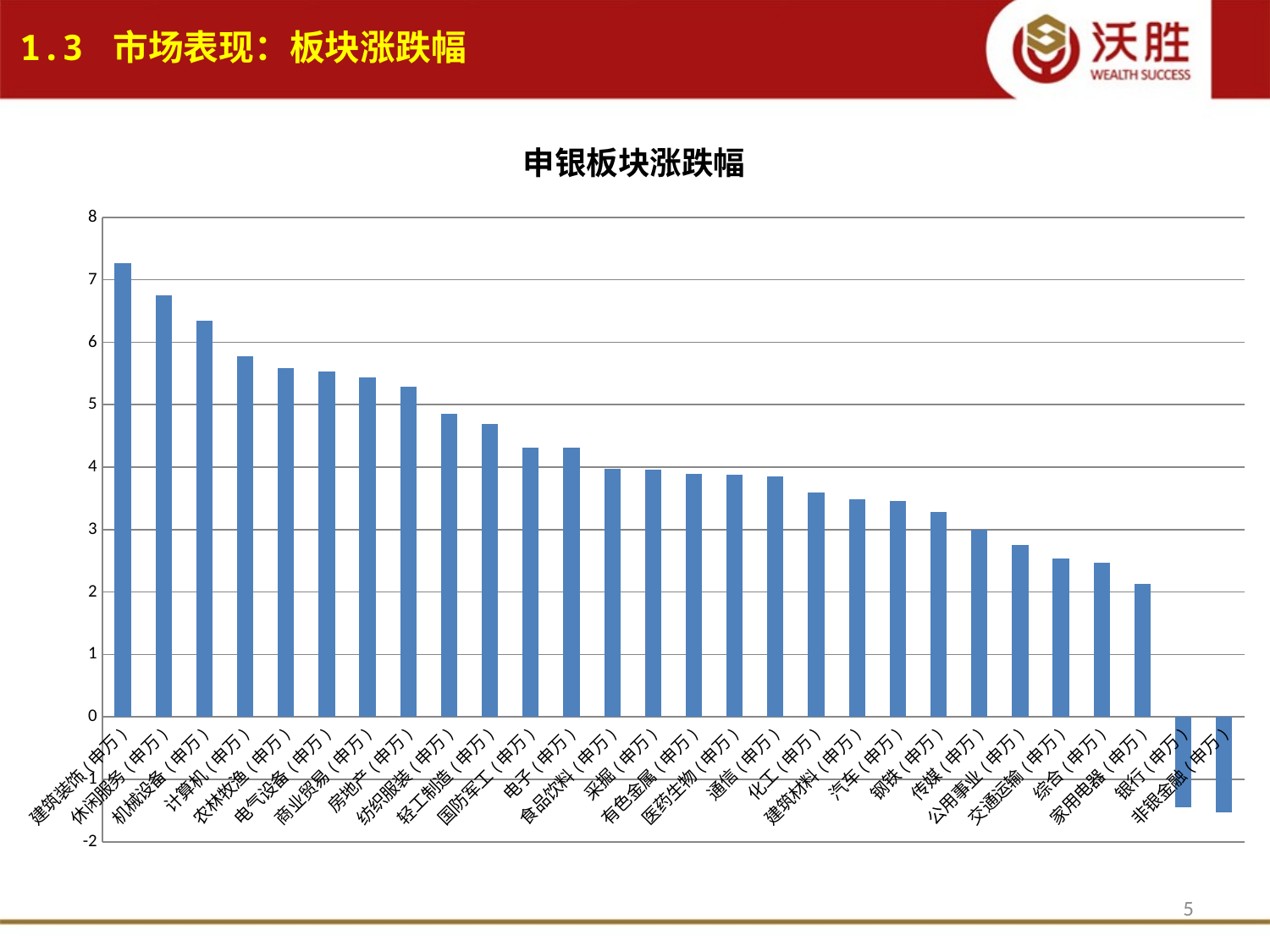
What is the title of the chart? 申银板块涨跌幅 Which sector has the highest value in the chart? 建筑装饰(申万) What kind of chart is shown on the slide? Bar chart Is the value for 建筑装饰(申万) greater or less than 7? greater Which is larger, the value for 钢铁(申万) or the value for 传媒(申万)? 钢铁(申万) Which is larger, the value for 机械设备(申万) or the value for 计算机(申万)? 机械设备(申万) Is the value for 房地产(申万) greater or less than 5? greater Is the value for 计算机(申万) greater or less than 6? less How many categories (sectors) are plotted in the chart? 28 Do the values generally rise or fall from left to right along the x axis? Fall